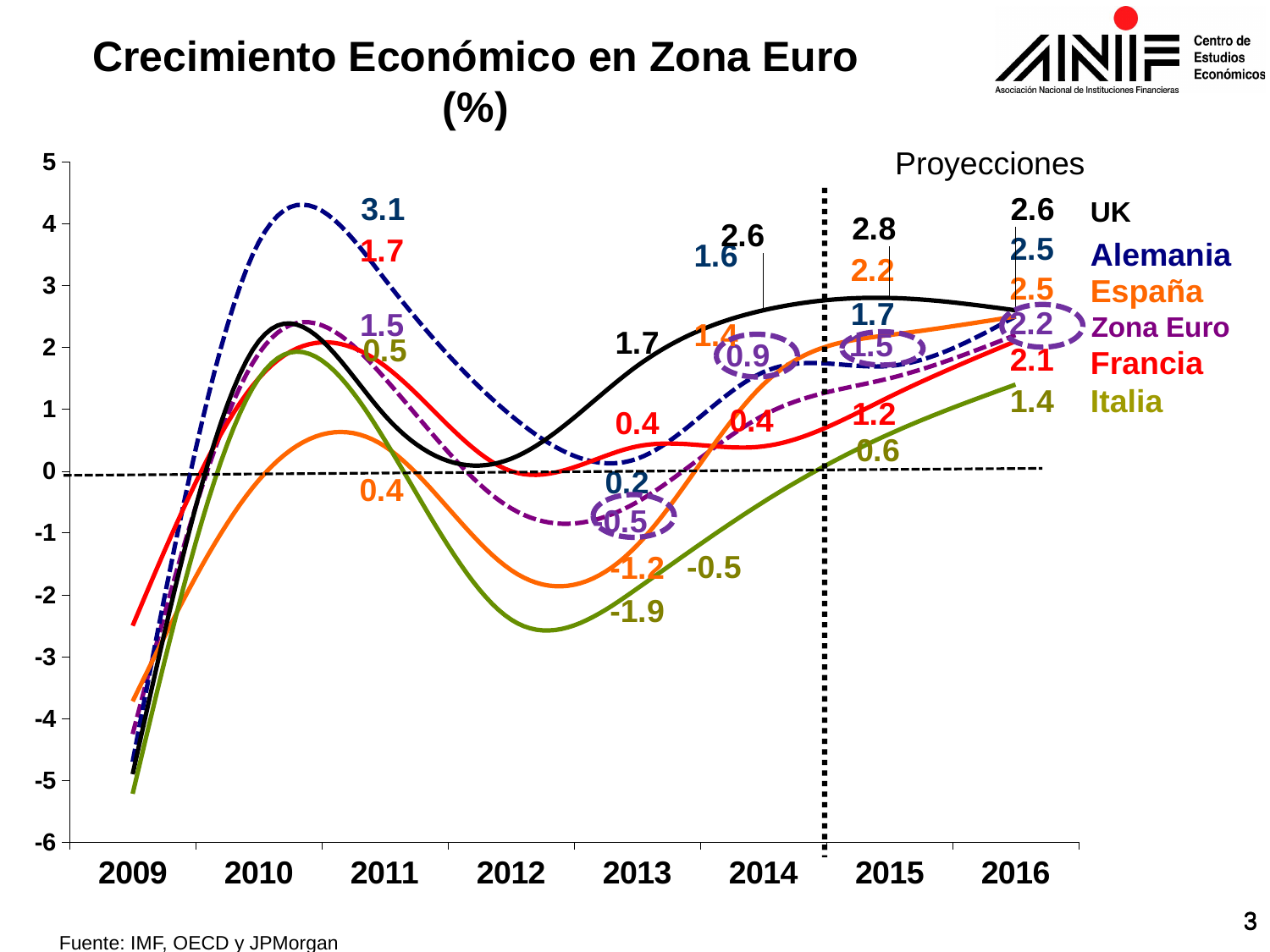
What is the projected economic growth for Italia in 2016? 1.4 What sources are cited for the chart? IMF, OECD y JPMorgan What is the difference between the 2016 values for UK and Italia? 1.2 What was the economic growth for Alemania in 2011? 3.1 Which series has the lowest projected value in 2016? Italia In 2016, which has the larger projected value, España or Francia? España What was the economic growth for Italia in 2013? -1.9 How many series (countries/regions) does the legend list? 6 Which series has the highest projected value in 2016? UK Is the value for Italia in 2012 greater or less than -2? less What kind of chart is shown on the slide? line chart What is the projected economic growth for UK in 2016? 2.6